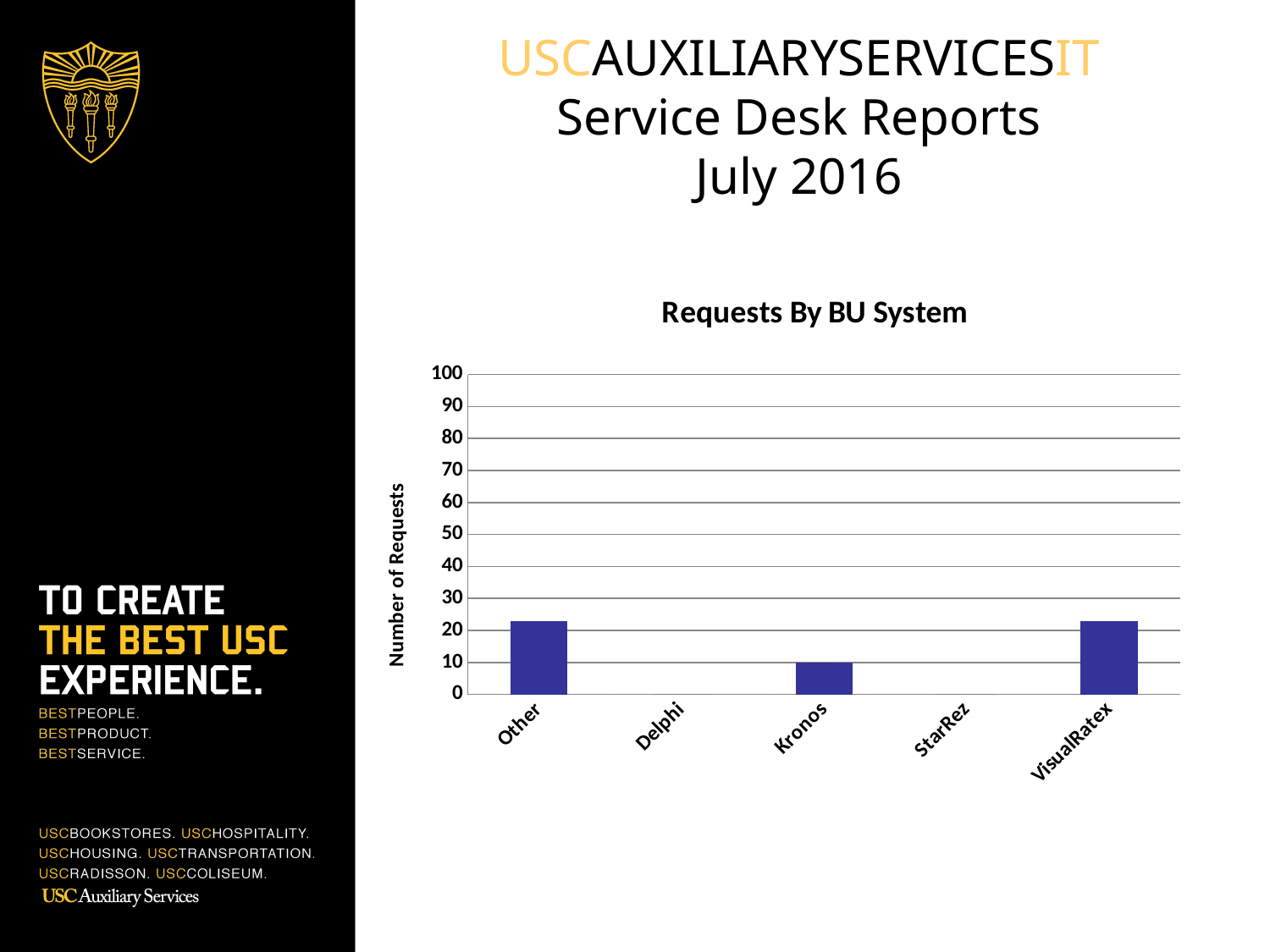
What is the label on the vertical axis of the chart? Number of Requests Is the value for Other greater or less than 20? greater Is the value for Kronos greater or less than 20? less Which has more requests, Kronos or VisualRatex? VisualRatex Which has more requests, Other or Kronos? Other How many categories are shown on the x axis of the chart? 5 Is the value for Other greater or less than 30? less How many categories in the chart have a visible bar? 3 Which has more requests, Kronos or Delphi? Kronos What is the title of the chart? Requests By BU System What kind of chart is shown on the slide? bar chart